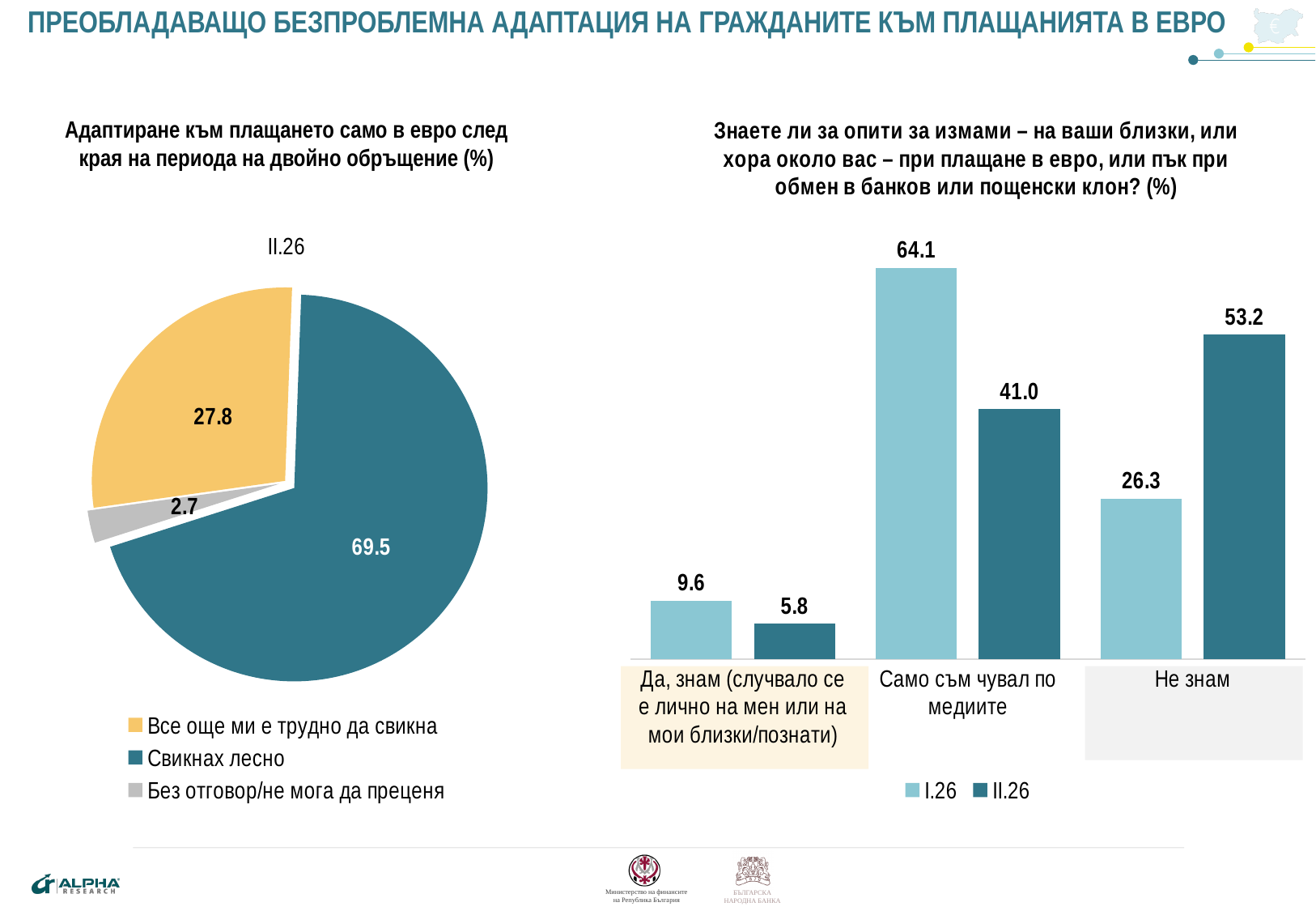
What kind of chart is shown on the right side of the slide? Bar chart In the bar chart on the right, what is the difference between the I.26 and II.26 values for "Само съм чувал по медиите"? 23.1 In the pie chart on the left, what is the value for "Все още ми е трудно да свикна"? 27.8 What kind of chart is shown on the left side of the slide? Pie chart In the bar chart on the right, what is the I.26 value for "Само съм чувал по медиите"? 64.1 In the bar chart on the right, which category has the lowest II.26 value? Да, знам (случвало се е лично на мен или на мои близки/познати) In the pie chart on the left, what is the value for "Свикнах лесно"? 69.5 In the bar chart on the right, which is larger for "Не знам": the I.26 value or the II.26 value? II.26 In the bar chart on the right, what is the II.26 value for "Не знам"? 53.2 In the pie chart on the left, how many slices does the pie have? 3 In the pie chart on the left, which category has the smallest slice? Без отговор/не мога да преценя How many series does the legend of the bar chart on the right list? 2